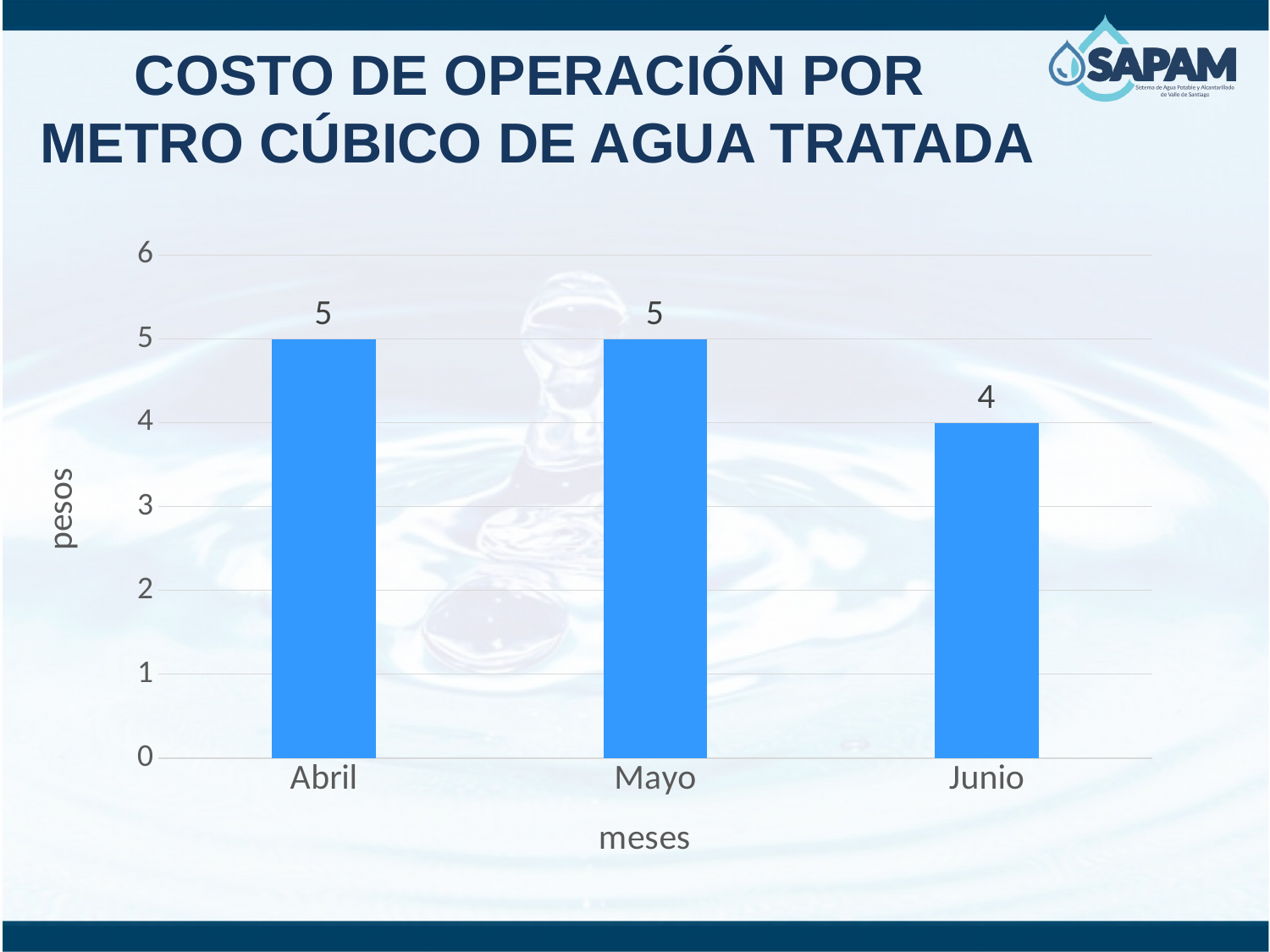
What kind of chart is shown on the slide? bar chart What is the value for Mayo? 5 Which is larger, the value for Abril or the value for Junio? Abril What is the value for Abril? 5 Is the value for Junio greater or less than 5? less What is the label of the horizontal axis? meses What is the value for Junio? 4 What is the label of the vertical axis? pesos How many months are shown on the x axis? 3 Which month has the lowest value? Junio Do the values rise or fall from Mayo to Junio? fall What is the difference between the values for Mayo and Junio? 1